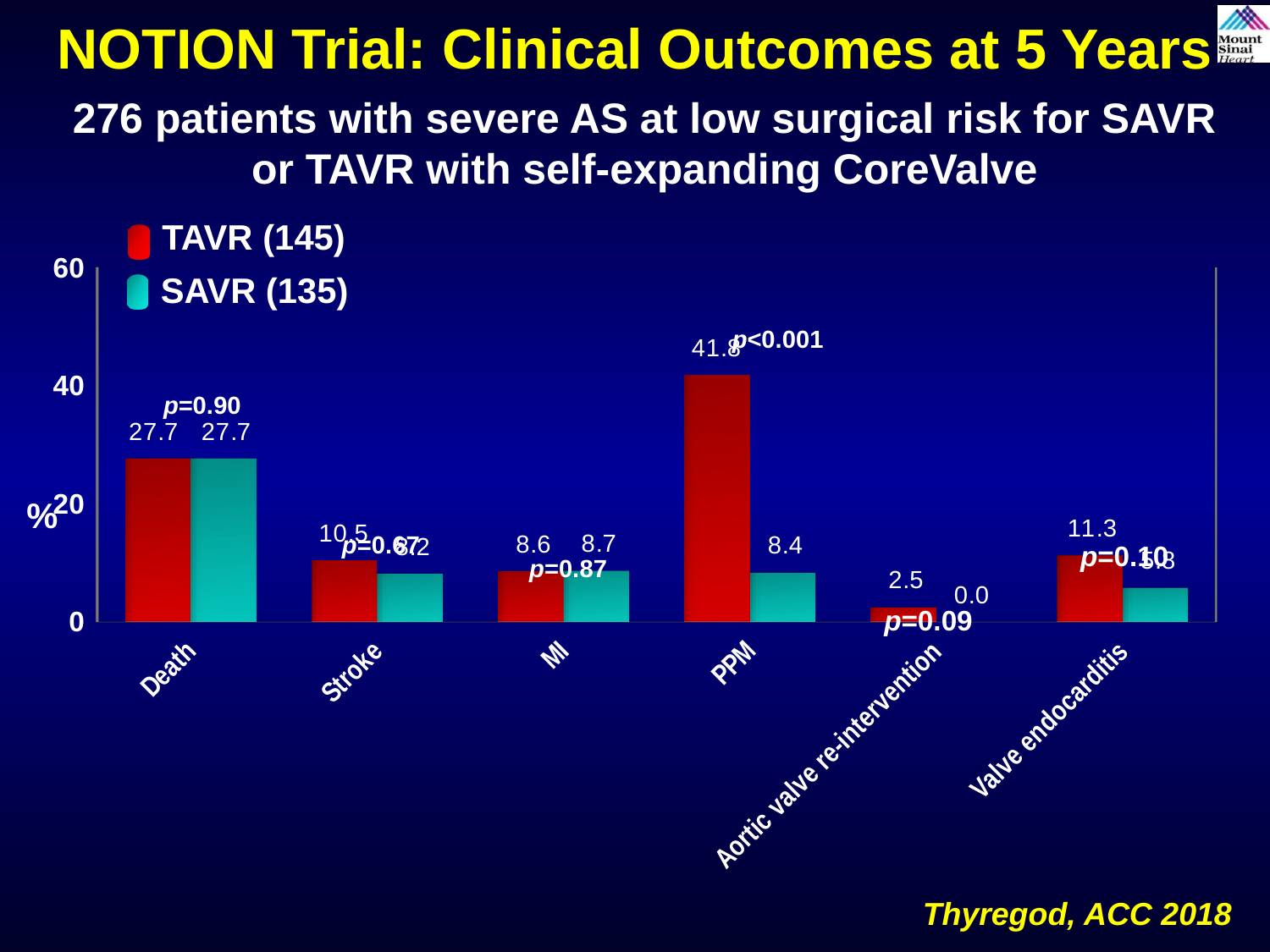
How many outcome categories are shown on the x axis? 6 What is the TAVR value for PPM? 41.8 What is the TAVR value for Death? 27.7 What is the SAVR value for Aortic valve re-intervention? 0.0 What is the TAVR value for MI? 8.6 How many series does the legend list? 2 Which category has the highest TAVR value? PPM For Valve endocarditis, which is larger, the TAVR value or the SAVR value? TAVR What is the difference between the TAVR and SAVR values for PPM? 33.4 What is the SAVR value for PPM? 8.4 What are the two legend entries of the chart? TAVR (145) and SAVR (135) What type of chart is shown on the slide? bar chart